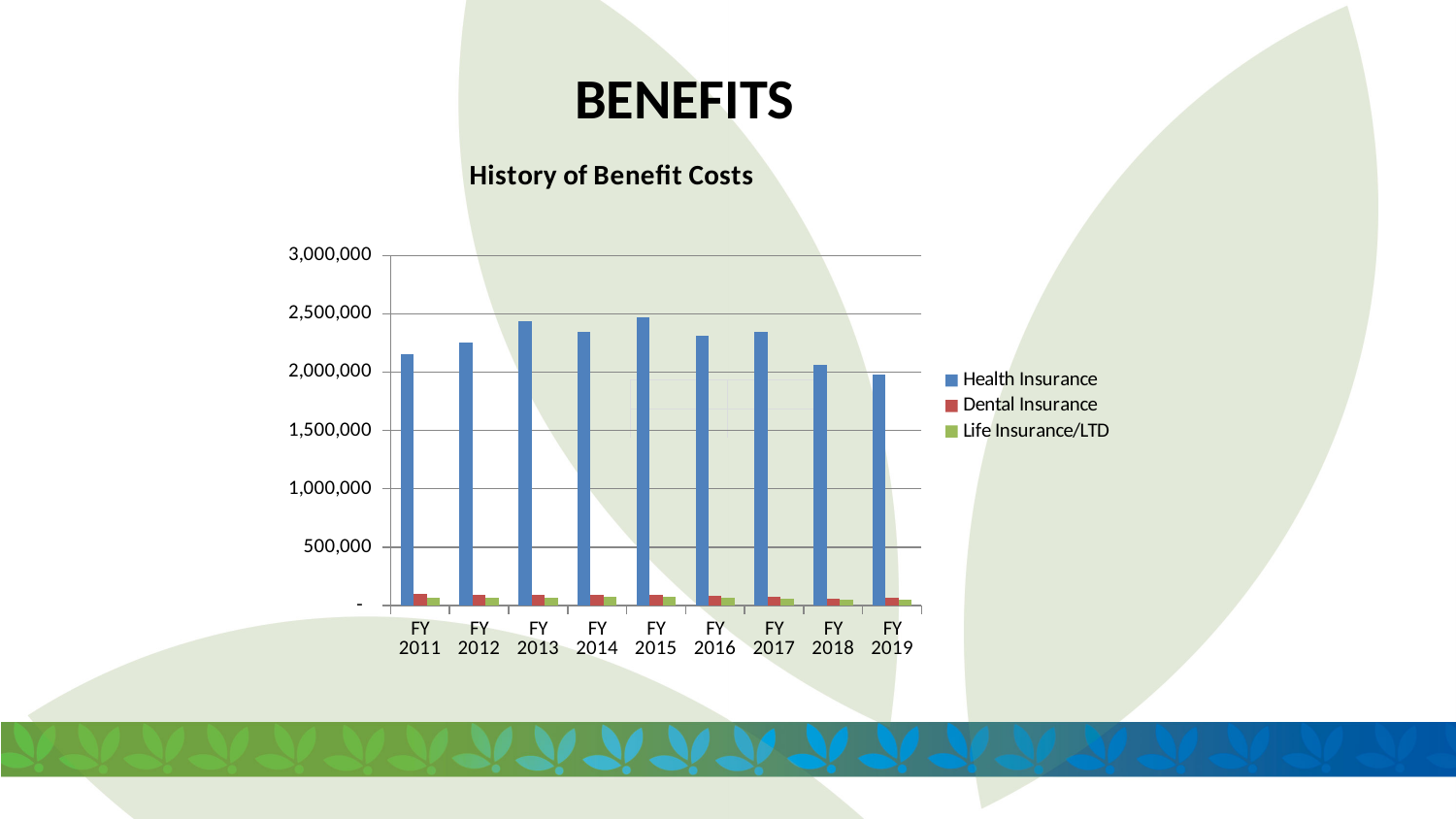
Does the Health Insurance cost rise or fall from FY 2017 to FY 2019? fall How many fiscal years are shown on the x axis? 9 Which is larger, the Health Insurance cost in FY 2012 or in FY 2018? FY 2012 Is the Dental Insurance value for FY 2011 greater or less than 500,000? less In which fiscal year is the Health Insurance cost lowest? FY 2019 Which series is shown in blue? Health Insurance What is the title of the chart? History of Benefit Costs Which series has the highest cost in FY 2016, Health Insurance or Life Insurance/LTD? Health Insurance What type of chart is shown on the slide? bar chart Is the Health Insurance value for FY 2013 greater or less than 2,000,000? greater How many series does the legend list? 3